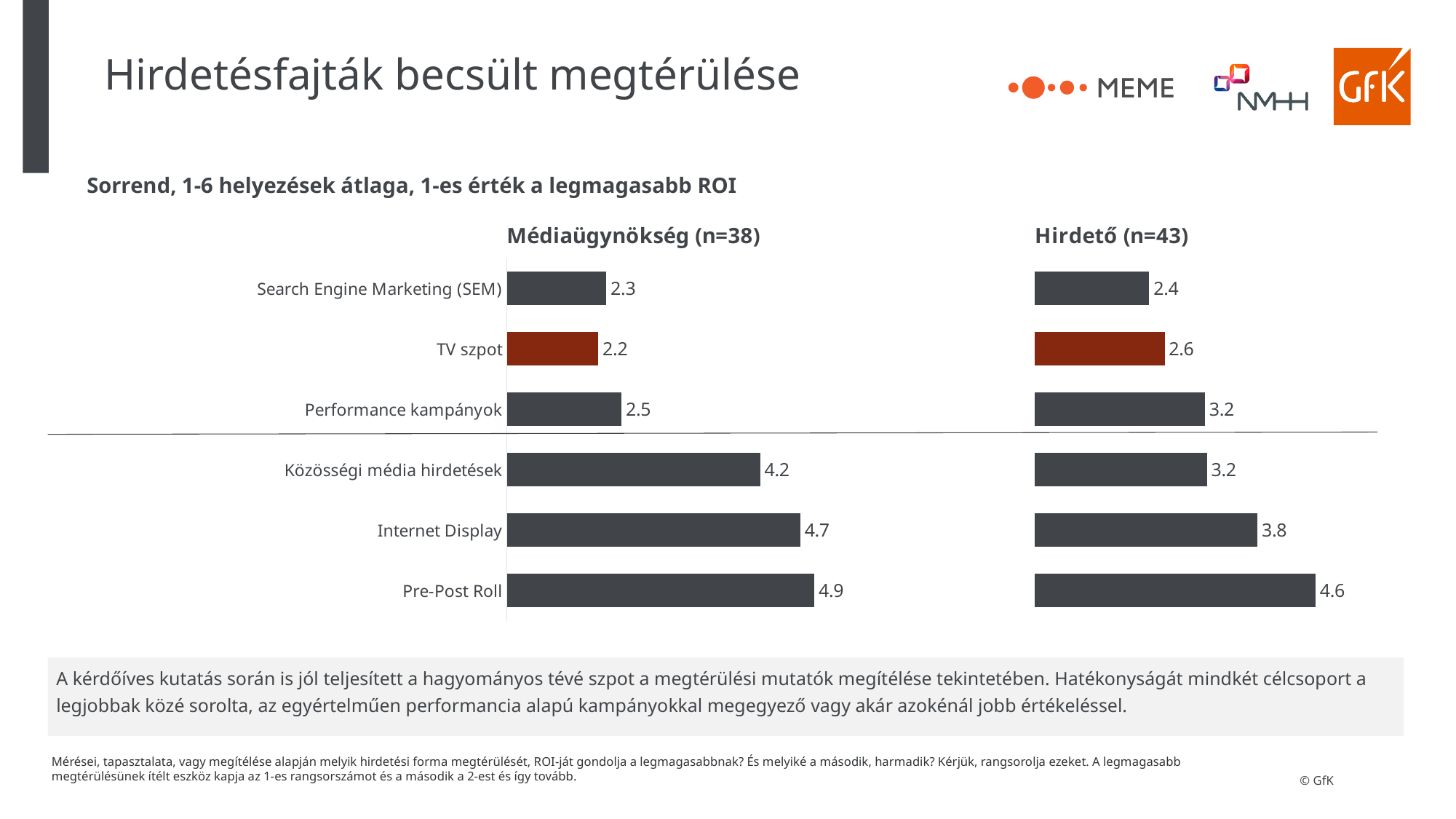
In the Hirdető (n=43) chart, which category has the lowest value? Search Engine Marketing (SEM) How many categories are shown in the Médiaügynökség (n=38) chart? 6 What kind of chart is the Hirdető (n=43) chart? Bar chart In the Hirdető (n=43) chart, what is the value for Search Engine Marketing (SEM)? 2.4 In the Médiaügynökség (n=38) chart, which category has the lowest value? TV szpot In the Médiaügynökség (n=38) chart, what is the difference between Internet Display and Közösségi média hirdetések? 0.5 In the Hirdető (n=43) chart, what is the value for Internet Display? 3.8 Which is larger: the value for Performance kampányok in the Médiaügynökség (n=38) chart or in the Hirdető (n=43) chart? Hirdető (n=43) In the Médiaügynökség (n=38) chart, which category's bar is coloured dark red instead of grey? TV szpot In the Médiaügynökség (n=38) chart, which category has the highest value? Pre-Post Roll In the Médiaügynökség (n=38) chart, what is the value for TV szpot? 2.2 In the Hirdető (n=43) chart, what is the difference between Pre-Post Roll and TV szpot? 2.0